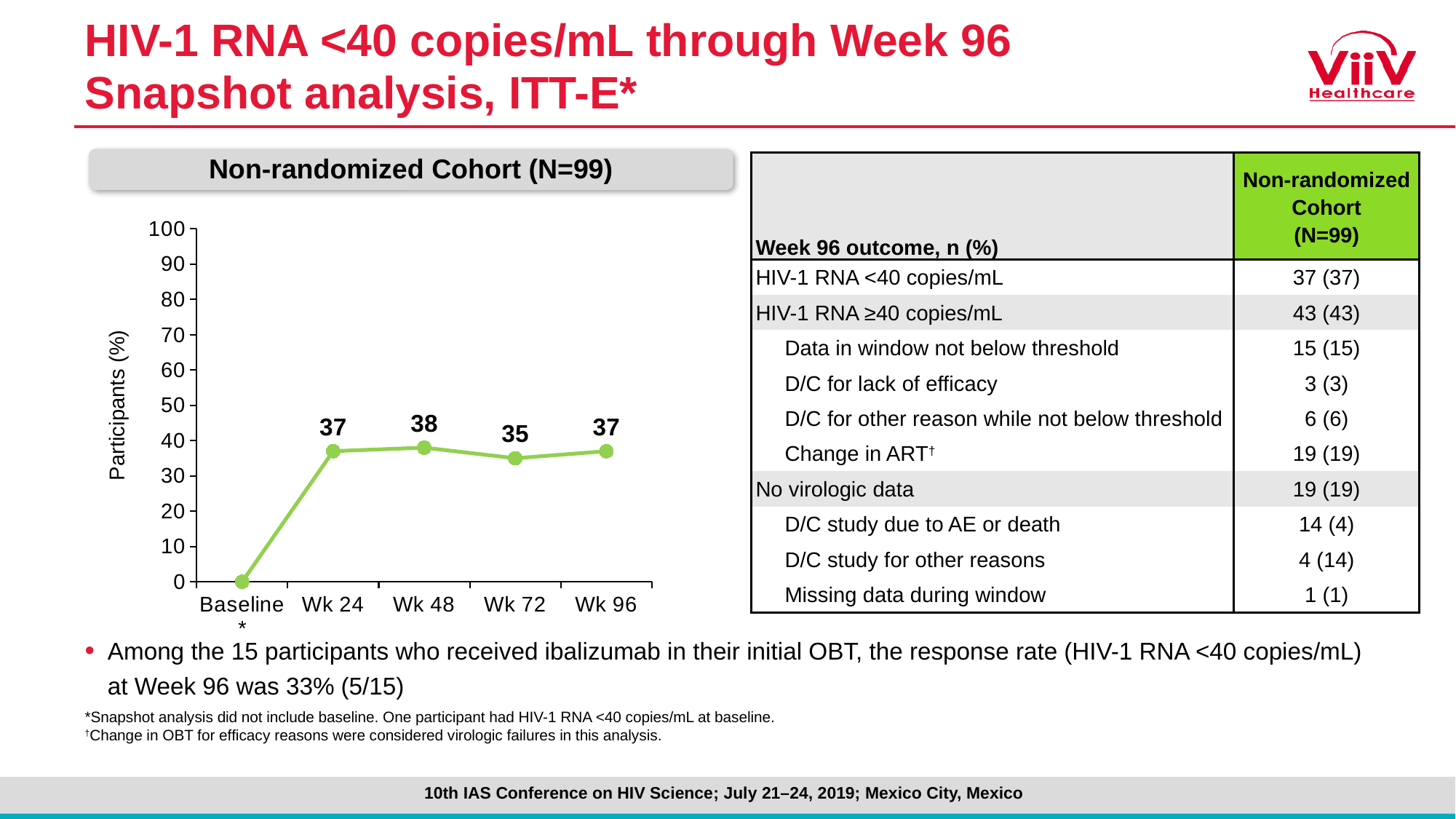
What is the value for Wk 96 in the Non-randomized Cohort chart? 37 Which time point has the lowest value in the Non-randomized Cohort chart? Baseline Is the value for Wk 96 in the Non-randomized Cohort chart greater or less than 50? less How many time points are plotted in the Non-randomized Cohort chart? 5 What is the value for Wk 72 in the Non-randomized Cohort chart? 35 Which time point has the highest value in the Non-randomized Cohort chart? Wk 48 Which is larger in the Non-randomized Cohort chart, the value at Wk 48 or at Wk 72? Wk 48 What is the y-axis label of the Non-randomized Cohort chart? Participants (%) What kind of chart is the Non-randomized Cohort chart? line chart What is the difference between the values at Wk 48 and Wk 72 in the Non-randomized Cohort chart? 3 What is the value for Wk 24 in the Non-randomized Cohort chart? 37 What is the value for Wk 48 in the Non-randomized Cohort chart? 38